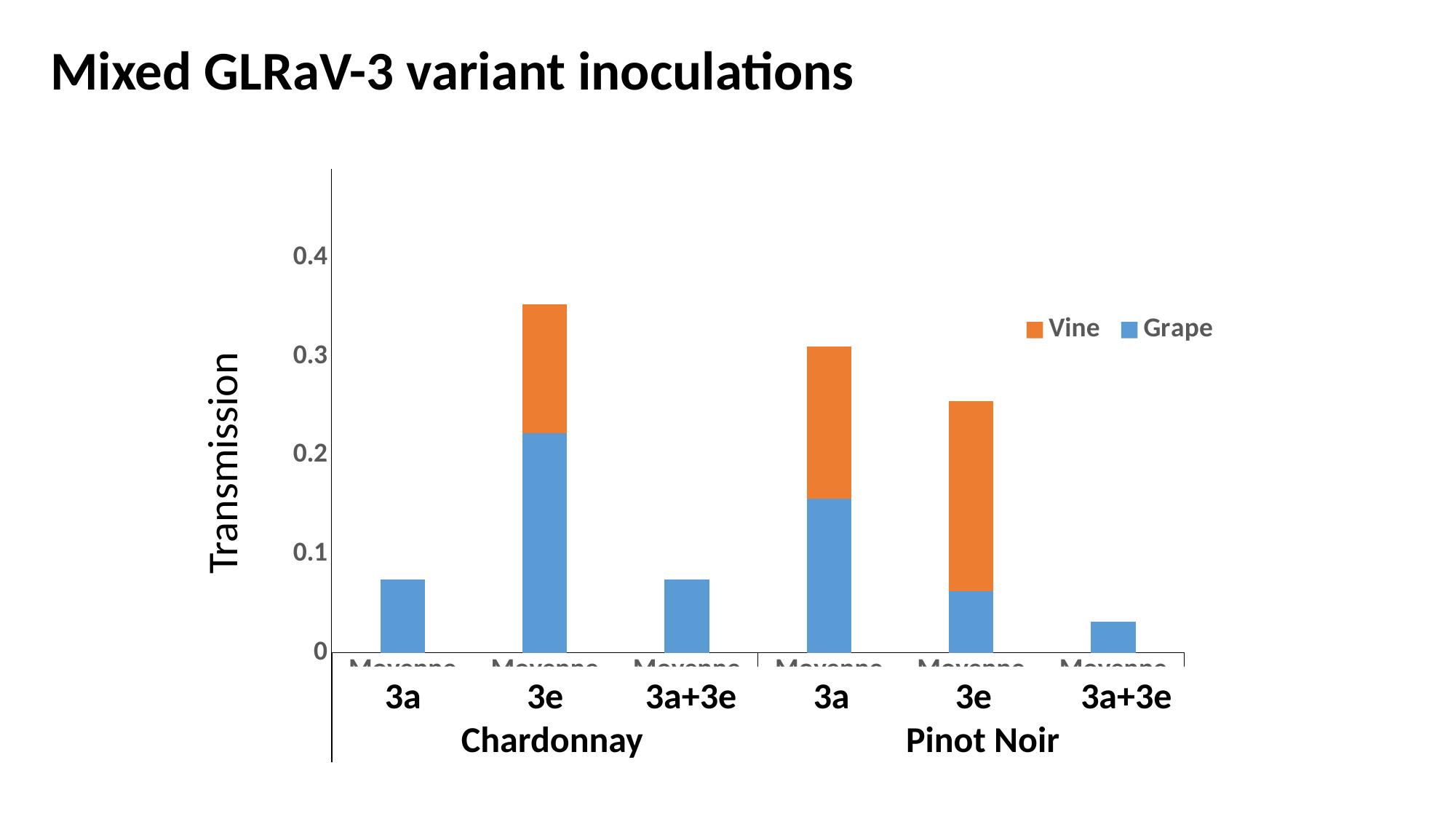
How many bars are plotted in the chart? 6 Which has the larger total transmission, Chardonnay 3e or Pinot Noir 3e? Chardonnay 3e What kind of chart is shown on the slide? Stacked bar chart Which bar has the lowest total transmission? Pinot Noir 3a+3e How many series does the legend list? 2 Is the Grape transmission for Chardonnay 3e greater or less than 0.2? greater What is the label on the vertical axis? Transmission What are the two series named in the legend? Vine and Grape Is the total transmission for Pinot Noir 3e greater or less than 0.3? less Is the total transmission for Chardonnay 3a greater or less than 0.1? less Which bar has the highest total transmission? Chardonnay 3e